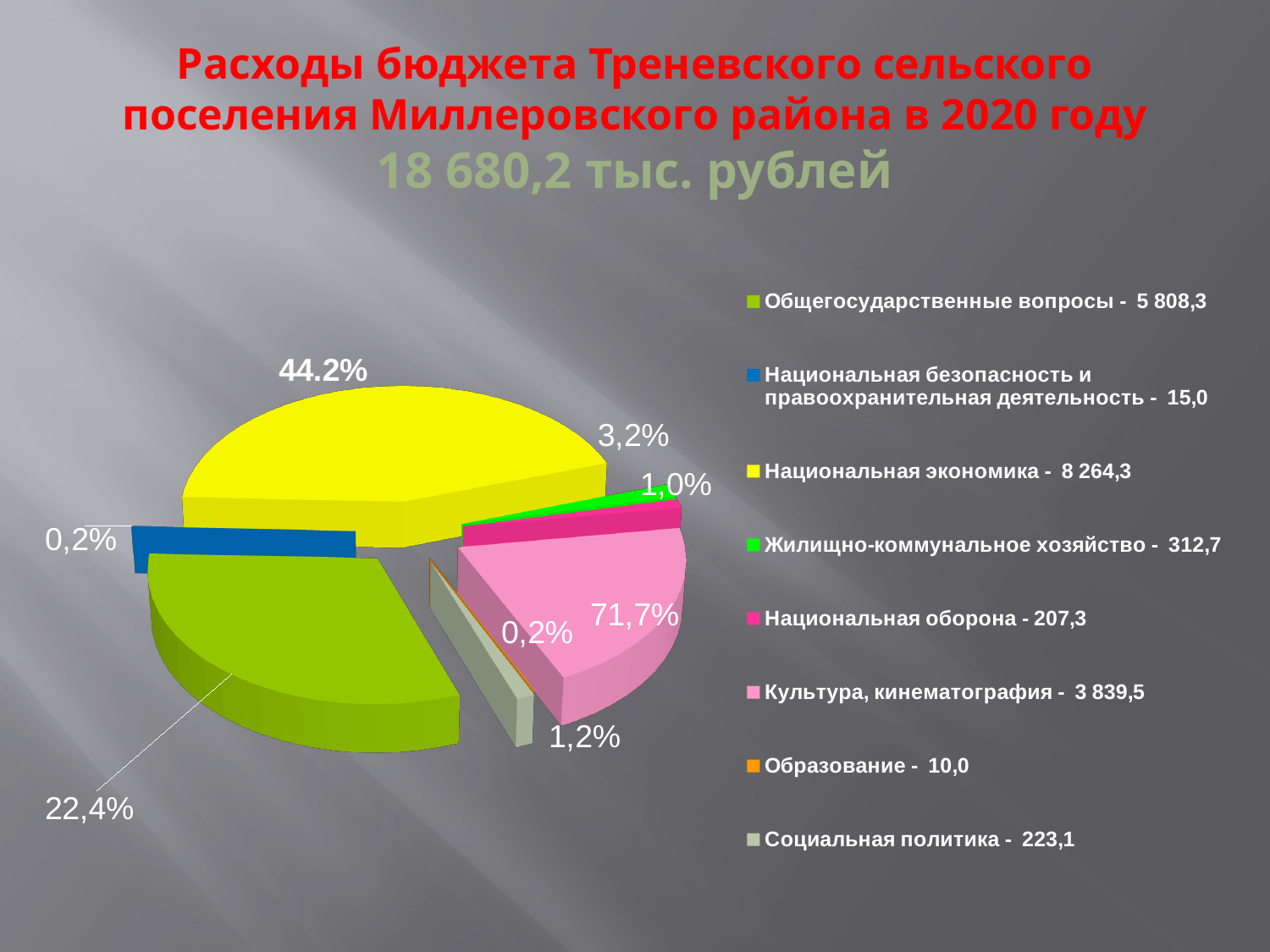
Which category has the largest value in the legend? Национальная экономика What value is given in the legend for Национальная экономика? 8 264,3 What percentage label is shown on the yellow slice (Национальная экономика)? 44.2% What is the difference between the values for Жилищно-коммунальное хозяйство and Национальная оборона? 105,4 How many expenditure categories does the legend list? 8 What total budget expenditure amount is stated in the slide title? 18 680,2 тыс. рублей What is the difference between the values for Национальная экономика and Общегосударственные вопросы? 2 456,0 Which is larger: Общегосударственные вопросы or Культура, кинематография? Общегосударственные вопросы What kind of chart is shown on the slide? pie chart What value is given in the legend for Социальная политика? 223,1 What value is given in the legend for Культура, кинематография? 3 839,5 Which category has the smallest value in the legend? Образование